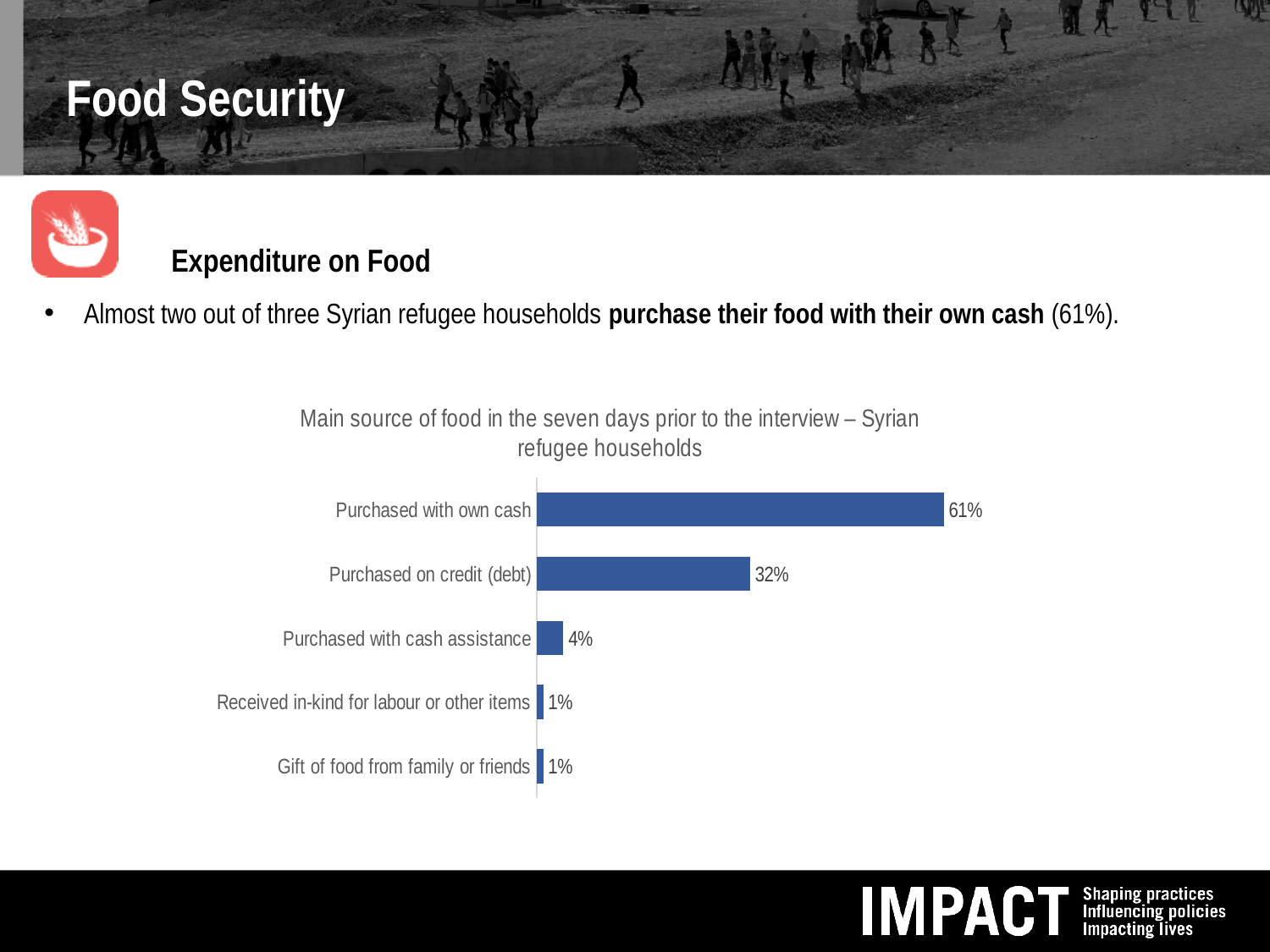
What percentage of Syrian refugee households purchased food with their own cash? 61% Which is larger: 'Purchased with cash assistance' or 'Gift of food from family or friends'? Purchased with cash assistance How many categories have a value of 1%? 2 Which main source of food has the highest value? Purchased with own cash What kind of chart is shown on the slide? Bar chart What is the value for 'Purchased on credit (debt)'? 32% What is the title of the chart? Main source of food in the seven days prior to the interview – Syrian refugee households What is the difference between 'Purchased with own cash' and 'Purchased on credit (debt)'? 29% What is the value for 'Received in-kind for labour or other items'? 1% What is the value for 'Purchased with cash assistance'? 4% What is the difference between 'Purchased on credit (debt)' and 'Purchased with cash assistance'? 28% How many categories are shown in the chart? 5